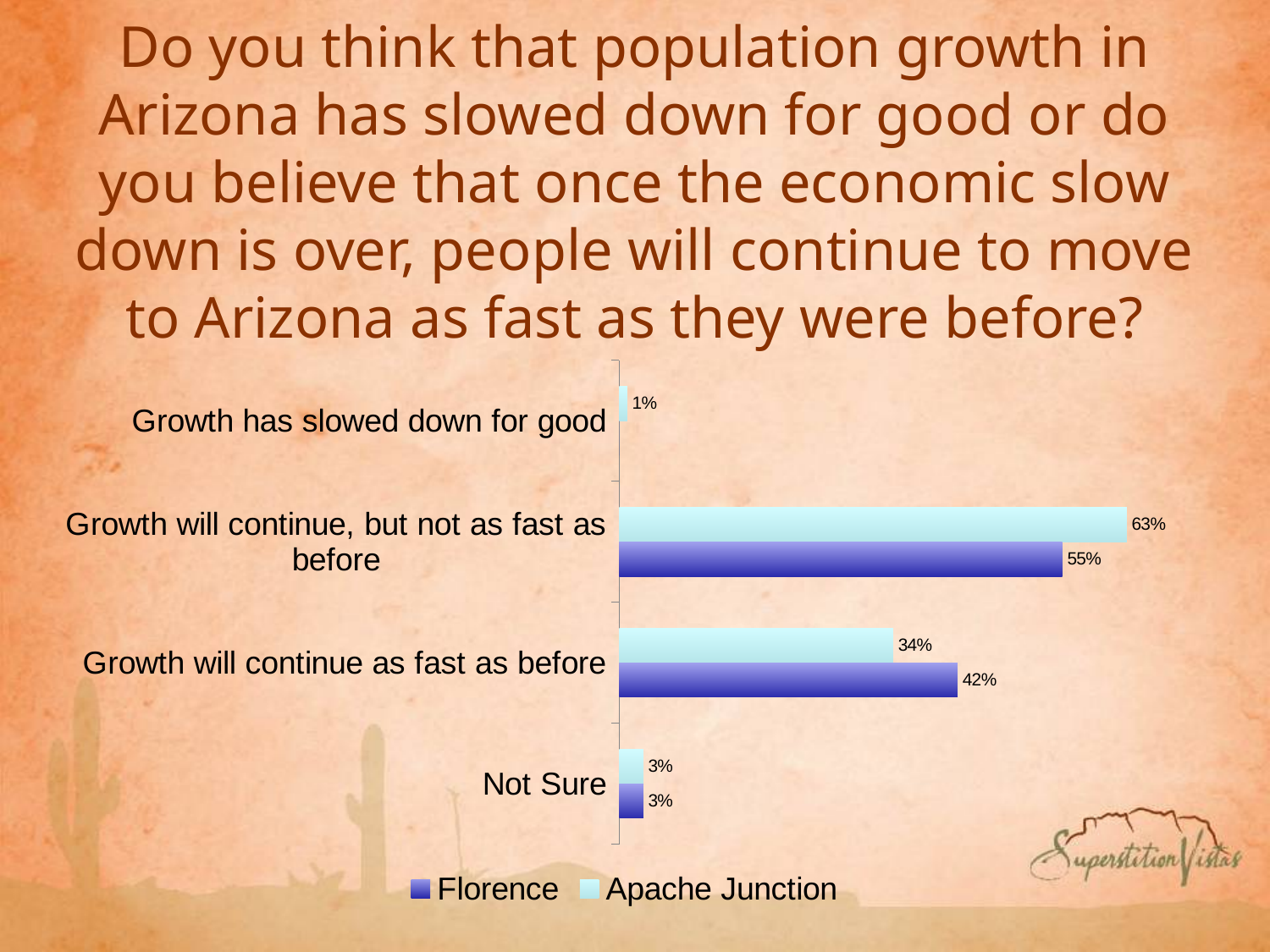
What percentage of Florence respondents said growth will continue, but not as fast as before? 55% Which response category has the highest value for Apache Junction? Growth will continue, but not as fast as before Which response category has the highest value for Florence? Growth will continue, but not as fast as before What percentage of Florence respondents said growth will continue as fast as before? 42% What percentage of Apache Junction respondents said growth will continue, but not as fast as before? 63% What kind of chart is shown on the slide? Bar chart What percentage of Florence respondents were Not Sure? 3% How many series does the legend list? 2 How many response categories are shown on the chart? 4 For 'Growth will continue as fast as before', which is larger: Florence or Apache Junction? Florence What is the difference between the Apache Junction and Florence values for 'Growth will continue, but not as fast as before'? 8% What percentage of Apache Junction respondents said growth will continue as fast as before? 34%